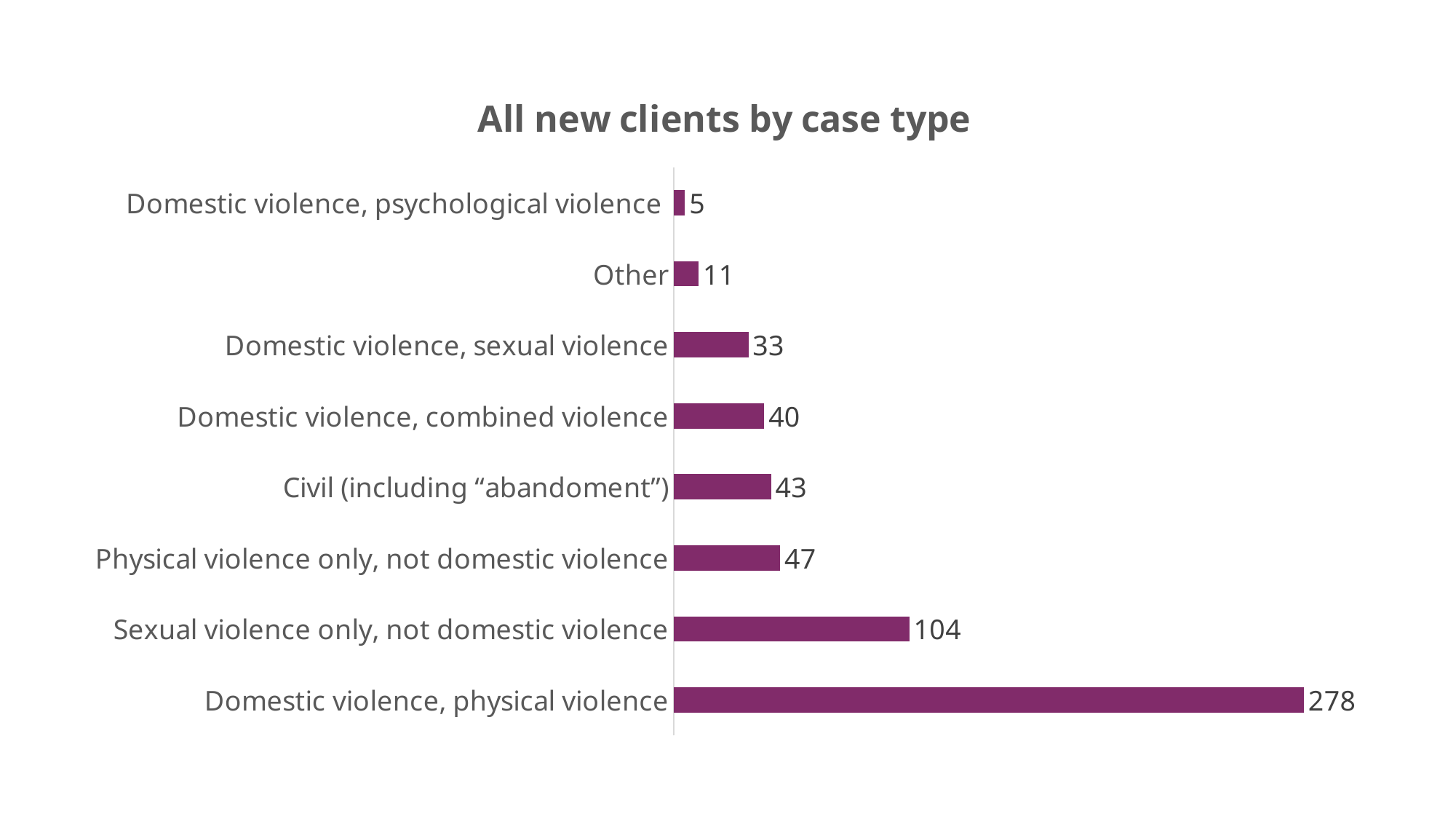
What is the title of the chart? All new clients by case type What is the value for "Other"? 11 Which case type has the lowest number of new clients? Domestic violence, psychological violence Which case type has the highest number of new clients? Domestic violence, physical violence What is the value for "Civil (including “abandoment”)"? 43 What is the difference between "Domestic violence, physical violence" and "Sexual violence only, not domestic violence"? 174 Which is larger: "Domestic violence, sexual violence" or "Domestic violence, combined violence"? Domestic violence, combined violence What is the value for "Domestic violence, physical violence"? 278 How many case type categories are shown in the chart? 8 What is the value for "Sexual violence only, not domestic violence"? 104 What is the difference between "Physical violence only, not domestic violence" and "Domestic violence, combined violence"? 7 What kind of chart is shown on the slide? Bar chart